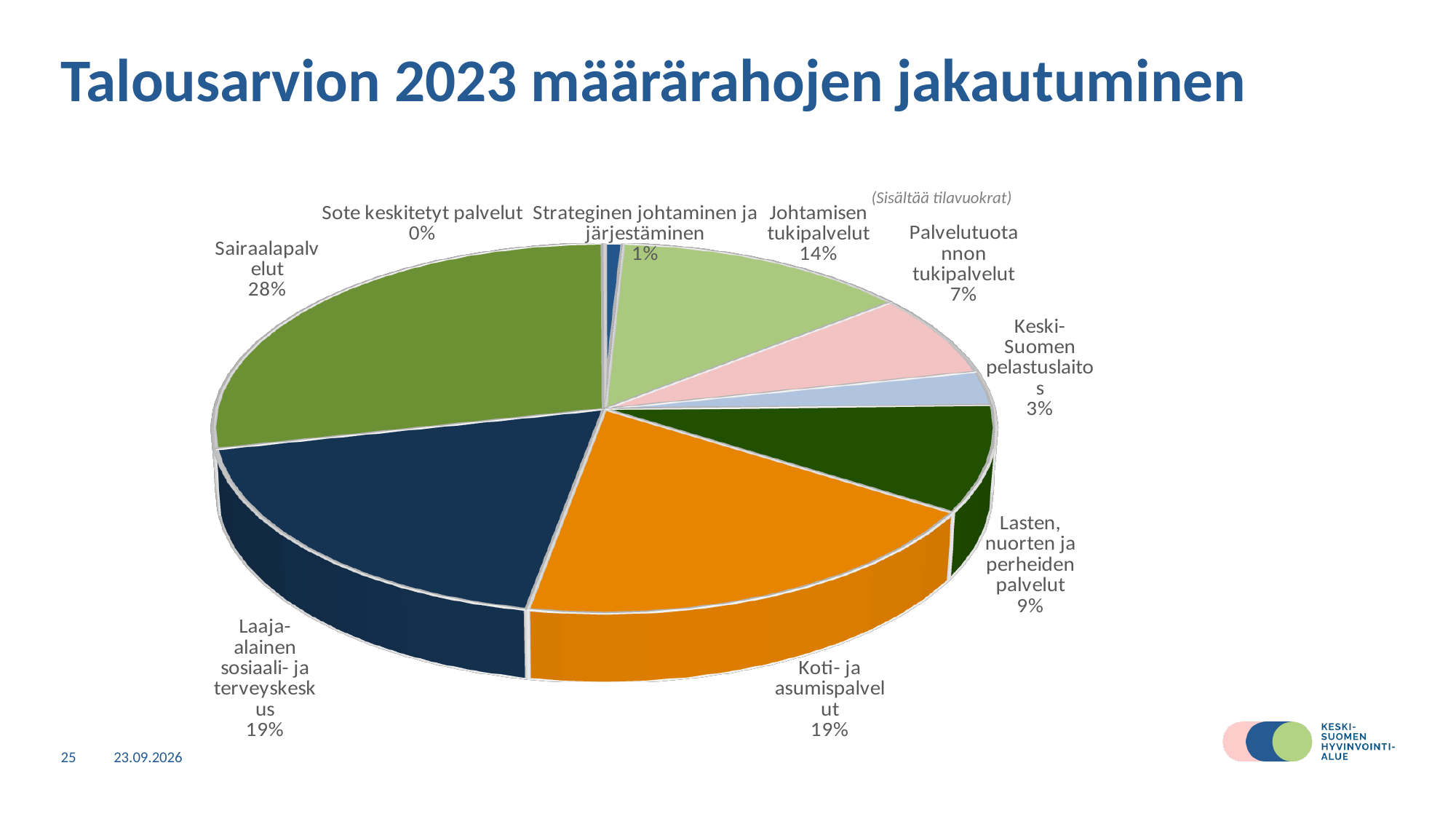
Which category has the smallest share of the pie? Sote keskitetyt palvelut What kind of chart is shown on the slide? Pie chart Which has a larger share, Johtamisen tukipalvelut or Lasten, nuorten ja perheiden palvelut? Johtamisen tukipalvelut How many categories are shown in the pie chart? 9 What share of the pie does Sairaalapalvelut have? 28% What share of the pie does Keski-Suomen pelastuslaitos have? 3% What share of the pie does Palvelutuotannon tukipalvelut have? 7% What share of the pie does Johtamisen tukipalvelut have? 14% Which category has the largest share of the pie? Sairaalapalvelut What is the difference in percentage points between Sairaalapalvelut and Koti- ja asumispalvelut? 9 What share of the pie does Lasten, nuorten ja perheiden palvelut have? 9% What is the title of the chart on the slide? Talousarvion 2023 määrärahojen jakautuminen